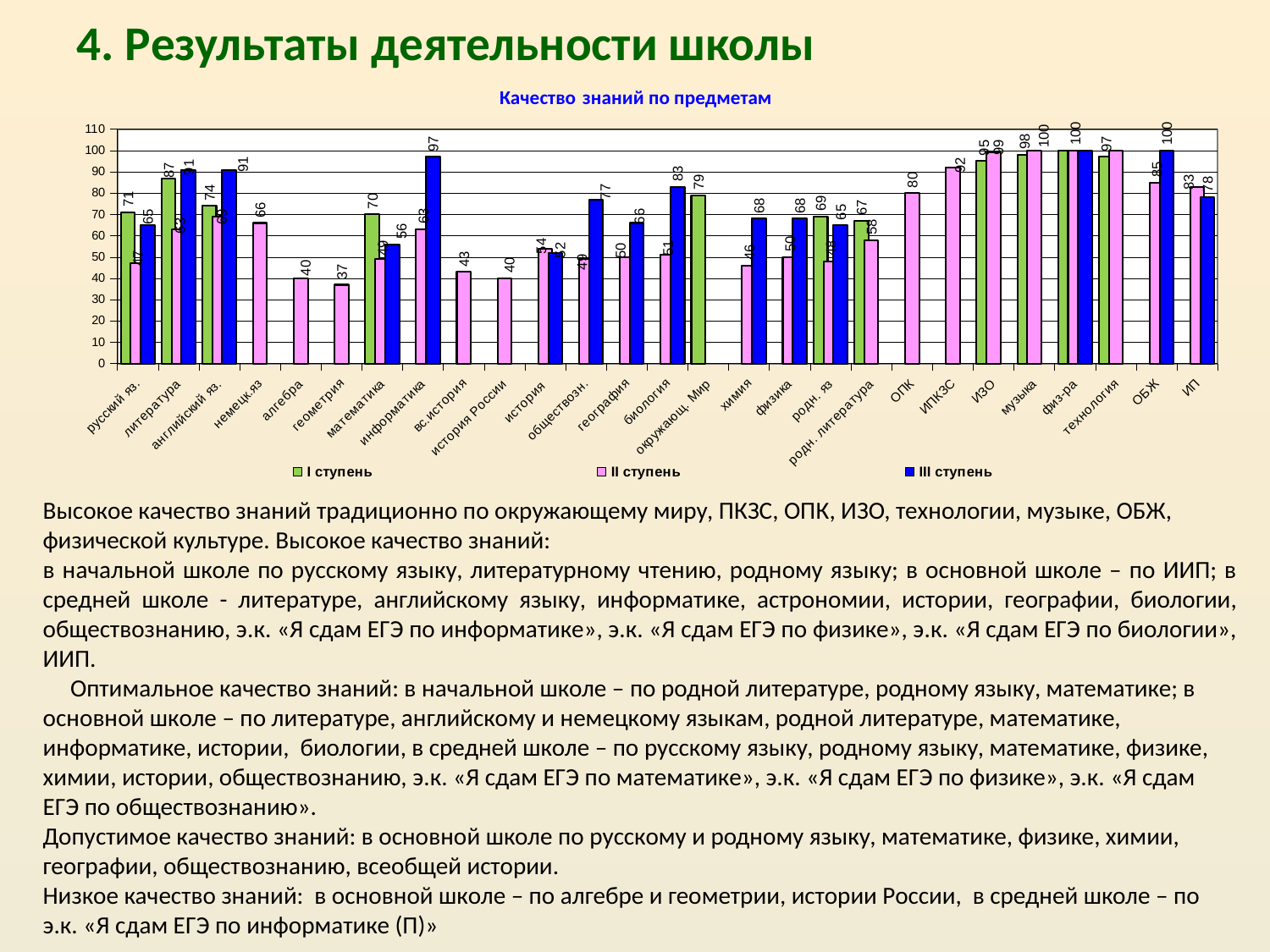
How many series does the legend list? 3 Which category has the lowest value on the chart? геометрия What is the value for информатика in the III ступень series? 97 Which is larger, the value for алгебра or the value for геометрия? алгебра What is the difference between the values for ИПКЗС and ОПК? 12 What is the title of the chart? Качество знаний по предметам What is the value for ИПКЗС (II ступень)? 92 What is the value for немецк.яз (II ступень)? 66 What is the value for ОПК (II ступень)? 80 What is the value for окружающ. Мир (I ступень)? 79 What is the value for геометрия (II ступень)? 37 What type of chart is shown on the slide? bar chart